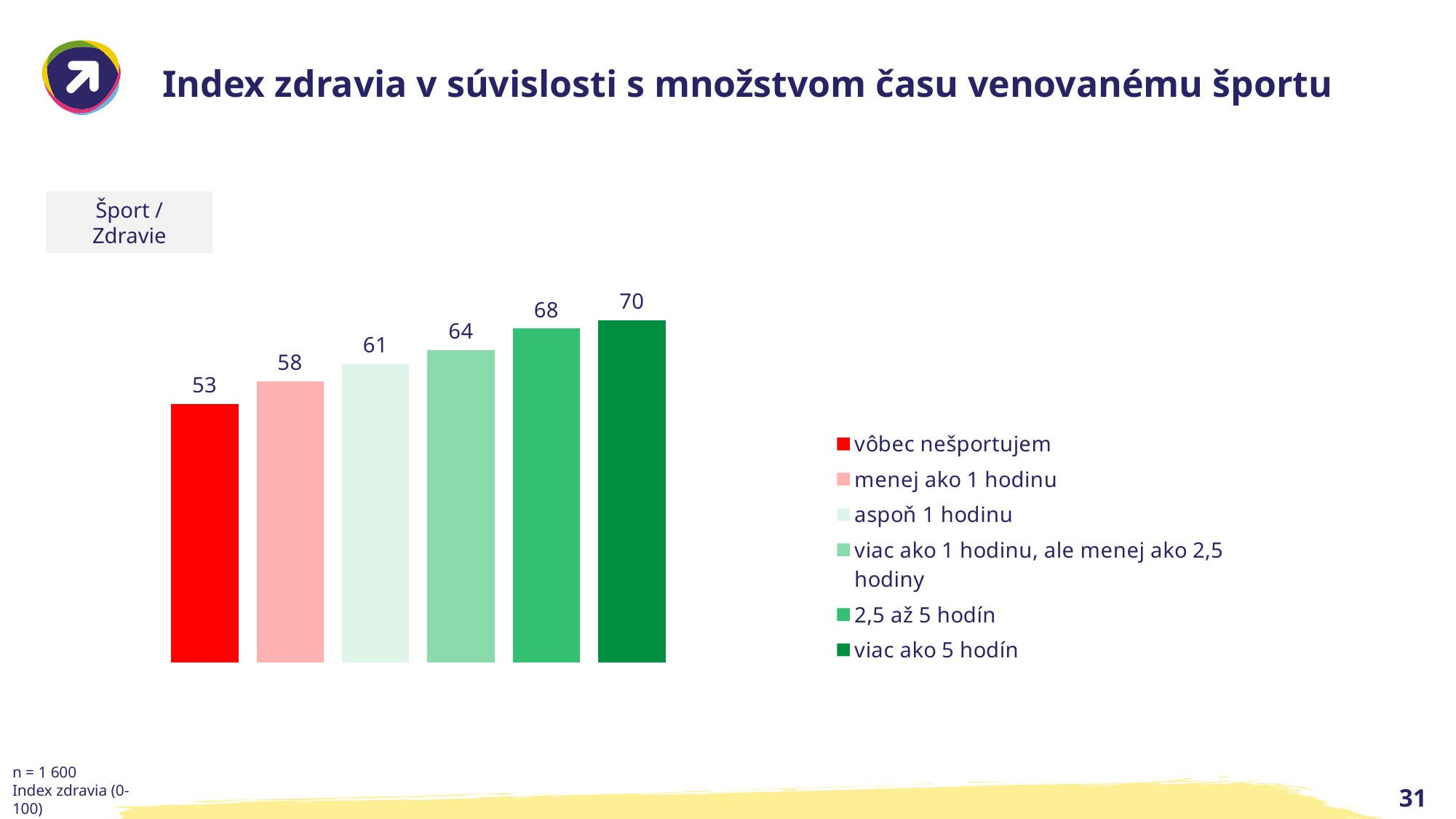
What is the difference between the health index for "viac ako 1 hodinu, ale menej ako 2,5 hodiny" and "menej ako 1 hodinu"? 6 What is the health index value for "viac ako 5 hodín"? 70 What is the health index value for "vôbec nešportujem"? 53 Do the health index values rise or fall from left to right across the bars? rise Which has a higher health index: "menej ako 1 hodinu" or "2,5 až 5 hodín"? 2,5 až 5 hodín Which category has the highest health index? viac ako 5 hodín What is the difference between the health index for "viac ako 5 hodín" and "vôbec nešportujem"? 17 What kind of chart is shown on the slide? bar chart What is the health index value for "aspoň 1 hodinu"? 61 What is the health index value for "2,5 až 5 hodín"? 68 How many categories are shown in the chart? 6 Which category has the lowest health index? vôbec nešportujem